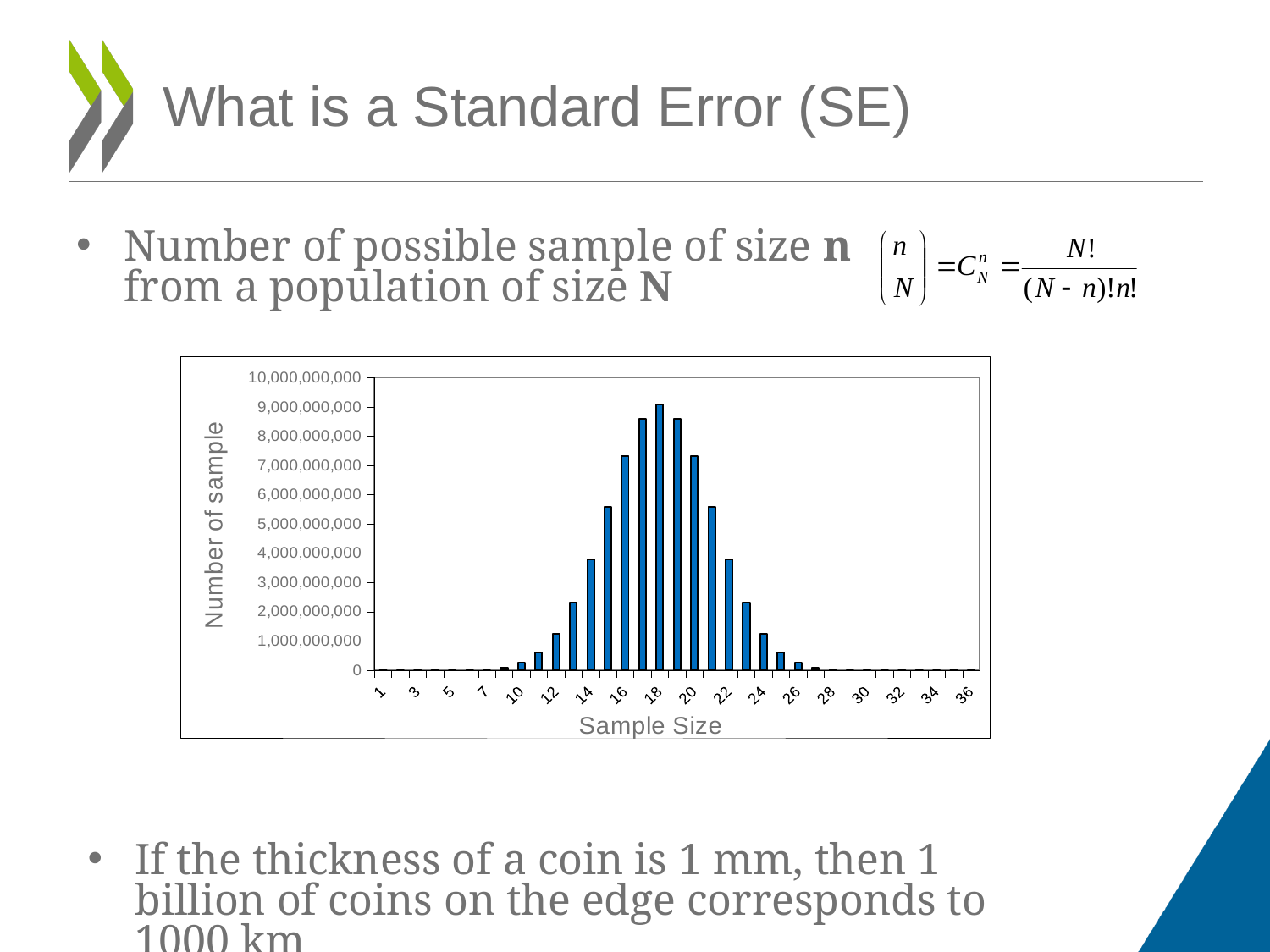
Is the value for sample size 18 greater or less than 8,000,000,000? greater Which has a larger number of samples, sample size 20 or sample size 24? 20 What is the title of the y axis? Number of sample Which sample size has the highest number of samples? 18 How many sample sizes are plotted along the x axis? 35 Is the value for sample size 16 greater or less than 6,000,000,000? greater Is the value for sample size 26 greater or less than 1,000,000,000? less How do the values change as sample size increases from 1 to 36? rise to a peak at 18, then fall Which has a larger number of samples, sample size 18 or sample size 16? 18 What kind of chart is shown on the slide? bar chart